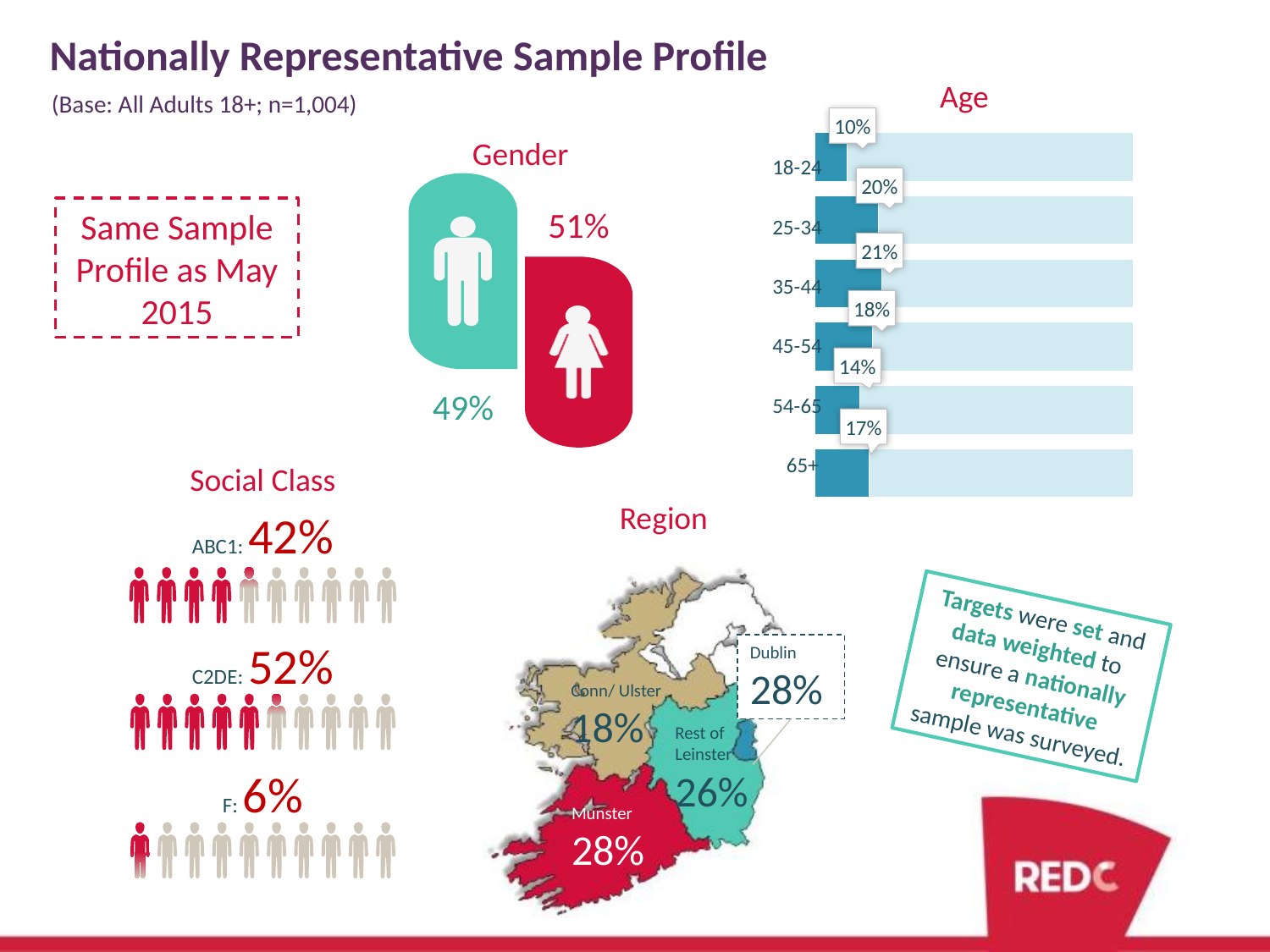
In the Age chart, what percentage of the sample is aged 18-24? 10% In the Age chart, what is the value for the 54-65 age group? 14% In the Age chart, what is the difference between the 25-34 and 18-24 age groups? 10% How many age groups are shown in the Age chart? 6 In the Region map, what percentage of the sample is from Rest of Leinster? 26% In the Age chart, which is larger: the value for 45-54 or the value for 54-65? 45-54 In the Age chart, which age group has the highest percentage? 35-44 What type of chart is the Age chart? Bar chart In the Social Class section, what percentage of the sample is C2DE? 52% In the Age chart, what percentage of the sample is aged 65+? 17% In the Age chart, which age group has the lowest percentage? 18-24 In the Age chart, what is the value for the 35-44 age group? 21%